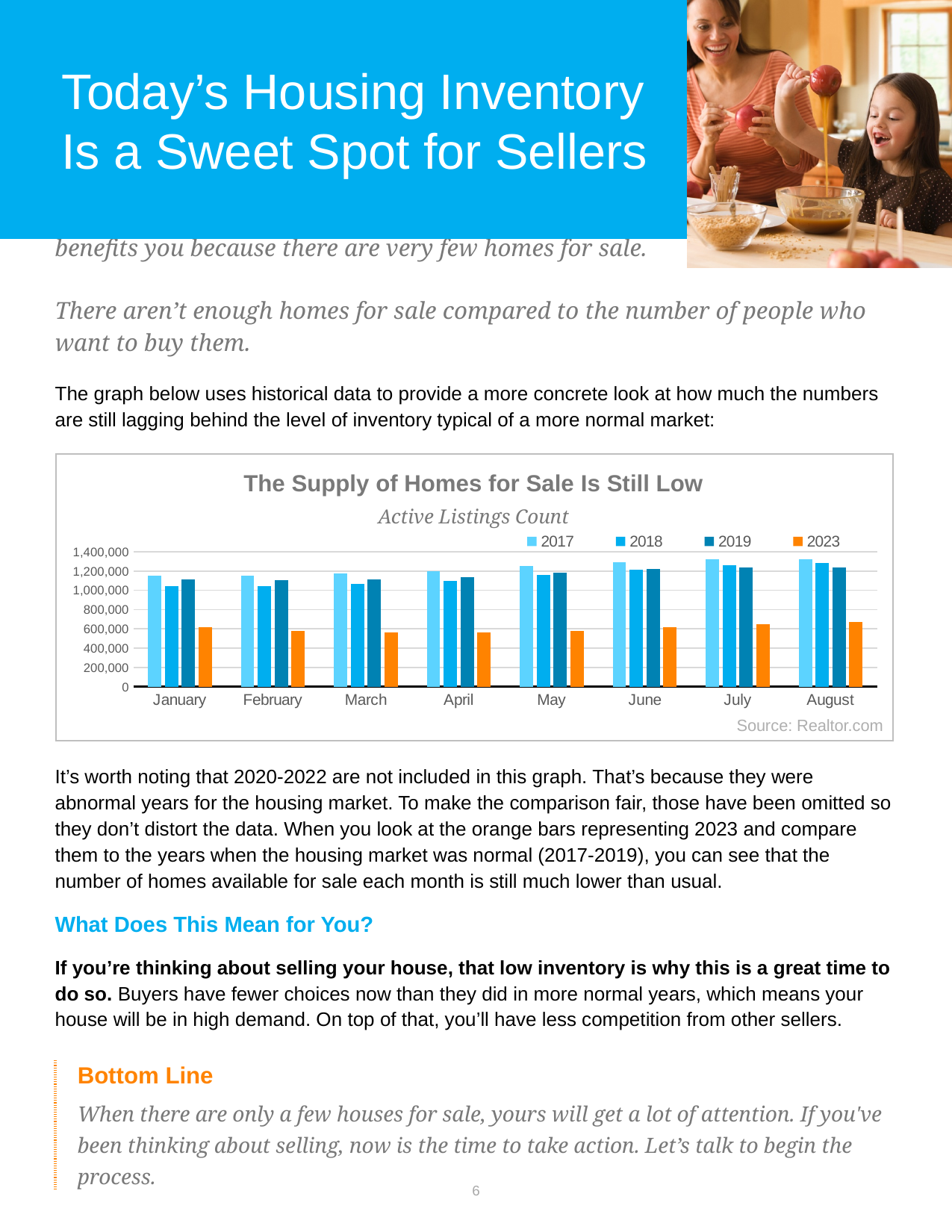
Do the 2023 values rise or fall from May to August? rise Is the value for 2017 in July greater or less than 1,200,000? greater How many series does the chart legend list? 4 What kind of chart is shown on the slide? bar chart Is the value for 2023 in August greater or less than 400,000? greater Is the value for 2023 in January greater or less than 800,000? less Which series has the lowest value in every month shown? 2023 What is the title of the chart? The Supply of Homes for Sale Is Still Low How many months are shown on the x axis of the chart? 8 In January, which series has the larger value, 2017 or 2023? 2017 What source is cited for the chart data? Realtor.com